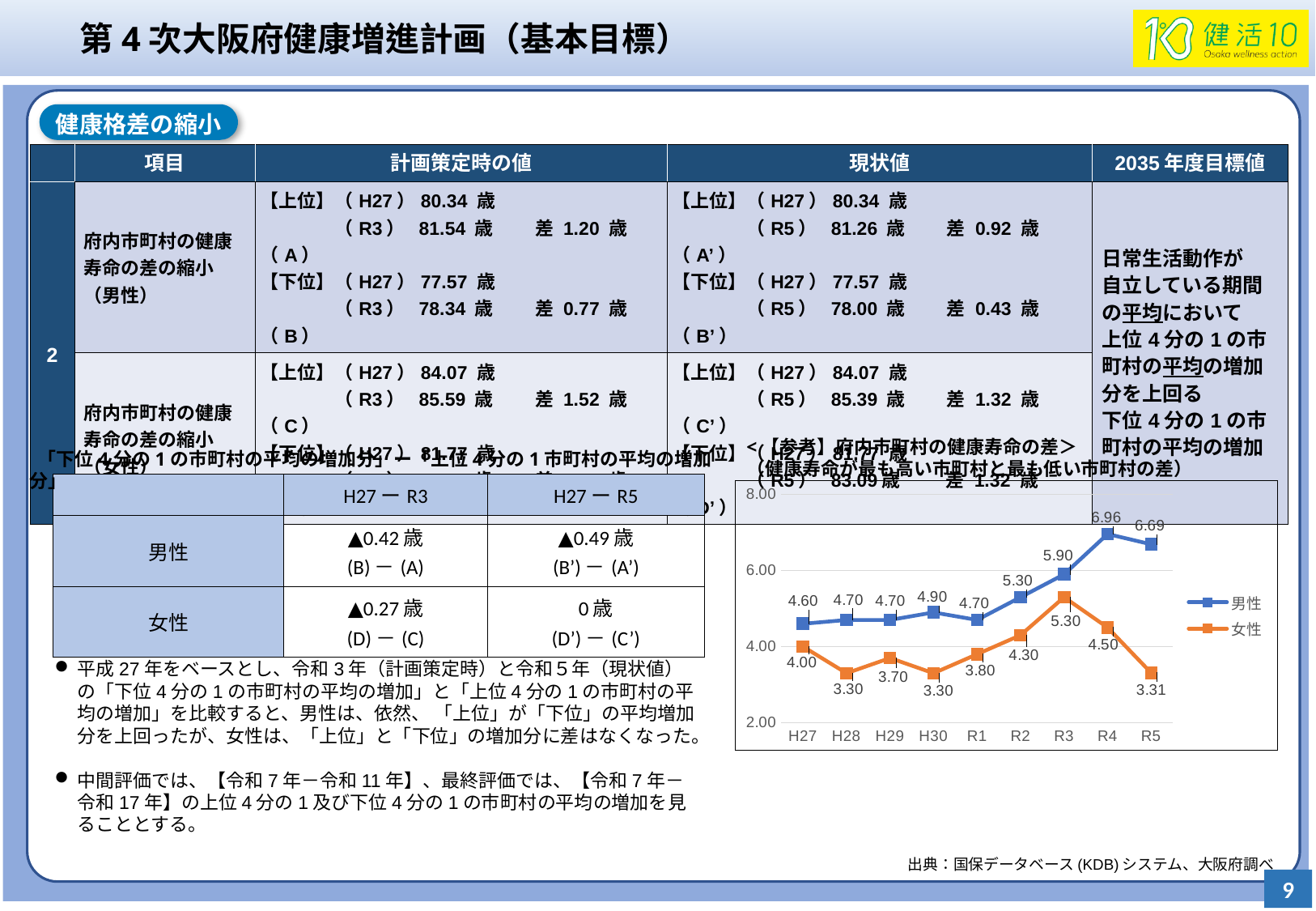
What is the value for 男性 at R4 in the chart? 6.96 Does the 男性 series generally rise or fall from H27 to R4? rise What kind of chart is shown on the slide? line chart What is the difference between the 男性 and 女性 values at R5? 3.38 How many points are plotted along the x axis for each series in the chart? 9 What is the value for 女性 at R5 in the chart? 3.31 What is the value for 男性 at H27 in the chart? 4.60 Which series is drawn in orange in the chart? 女性 In which year does the 男性 series reach its highest value? R4 In which year does the 女性 series reach its highest value? R3 Which series has the larger value at R3, 男性 or 女性? 男性 How many series does the chart legend list? 2